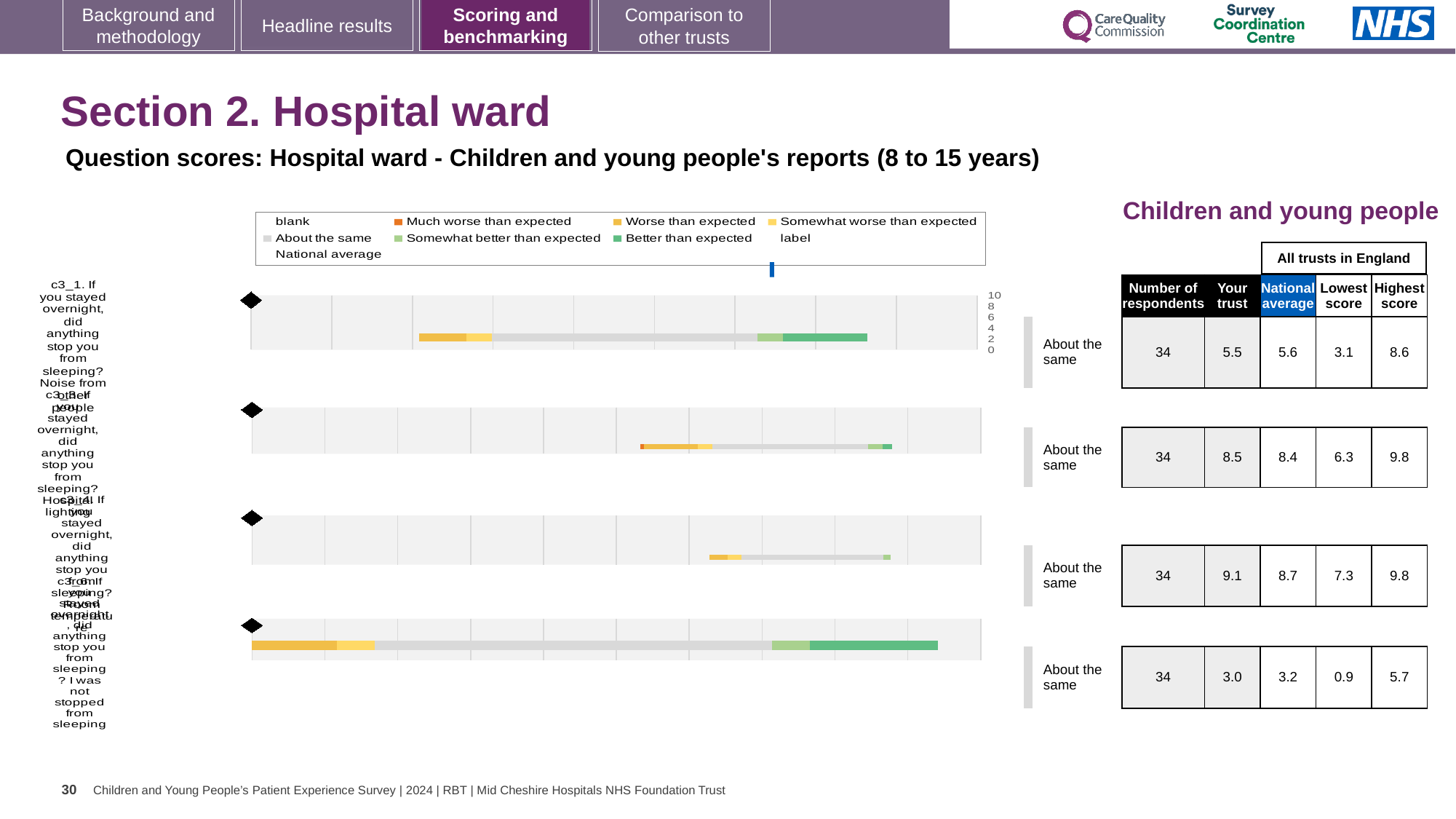
For the second chart from the top, what is the 'Your trust' score? 8.5 For the top chart (c3_1, noise from other people), what is the national average score? 5.6 For the bottom chart, which is larger: the 'Your trust' score or the national average? national average How many benchmark bar charts are shown on the slide? 4 Which of the four charts has the lowest 'Your trust' score? the bottom chart (3.0) For the third chart from the top, what is the difference between the 'Your trust' score and the national average? 0.4 How many respondents are listed for the bottom chart (c3_6)? 34 What kind of chart is used to show the question scores on this slide? bar chart For the bottom chart (c3_6, I was not stopped from sleeping), what is the lowest score among all trusts in England? 0.9 For the third chart from the top, what is the highest score among all trusts in England? 9.8 For the top chart (c3_1, noise from other people), what is the 'Your trust' score shown in the table? 5.5 Which of the four charts has the highest 'Your trust' score? the third chart from the top (9.1)